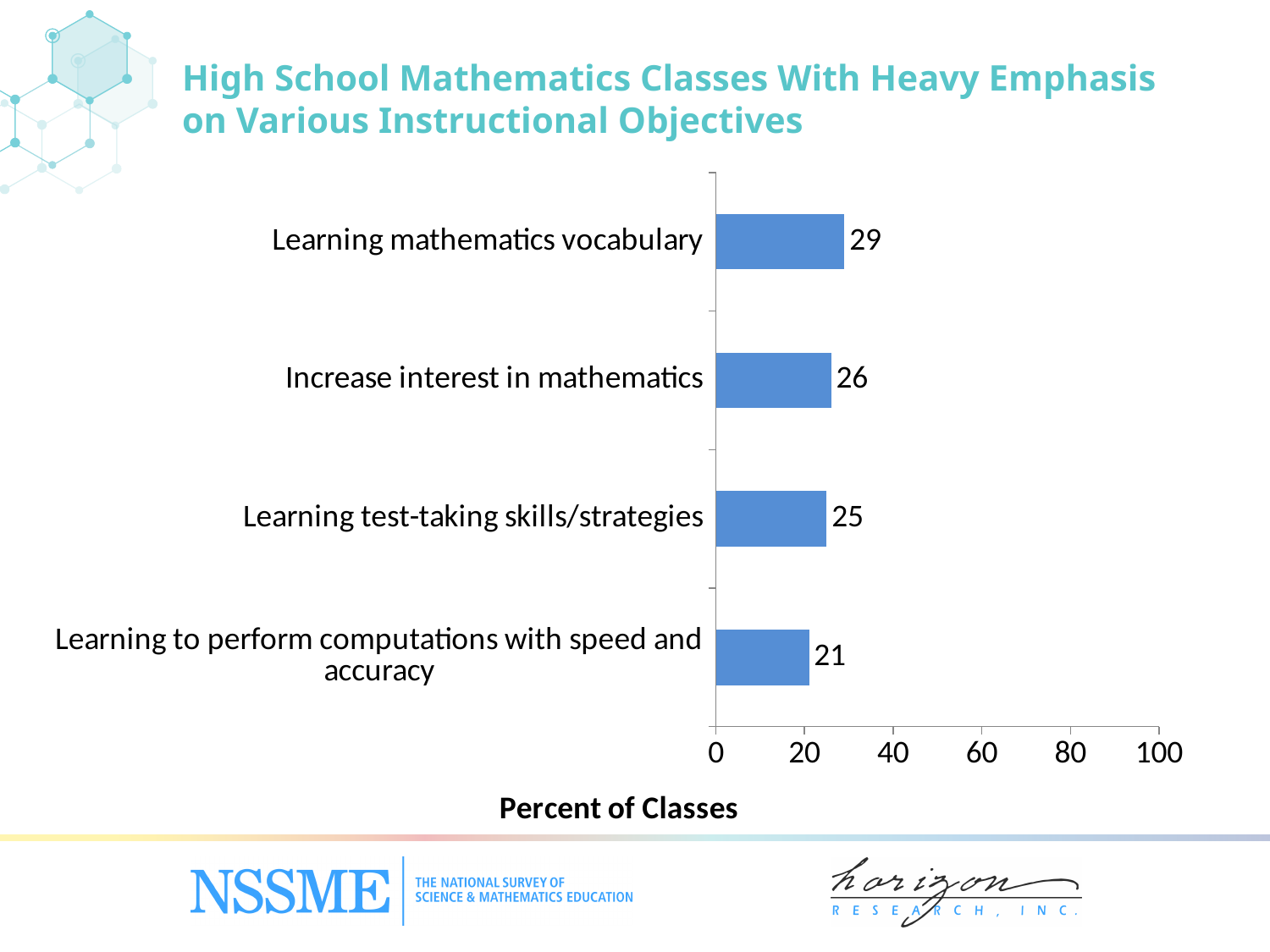
Which instructional objective has the highest percent of classes? Learning mathematics vocabulary Which is larger: the value for 'Increase interest in mathematics' or 'Learning to perform computations with speed and accuracy'? Increase interest in mathematics What is the difference between the values for 'Learning mathematics vocabulary' and 'Learning to perform computations with speed and accuracy'? 8 How many instructional objectives are shown in the chart? 4 What is the value for 'Learning test-taking skills/strategies'? 25 What percent of classes place heavy emphasis on learning to perform computations with speed and accuracy? 21 What is the label of the horizontal axis? Percent of Classes What kind of chart is shown on the slide? Bar chart Which instructional objective has the lowest percent of classes? Learning to perform computations with speed and accuracy What percent of classes place heavy emphasis on learning mathematics vocabulary? 29 Is the value for 'Learning mathematics vocabulary' greater or less than 40? less What is the value for 'Increase interest in mathematics'? 26